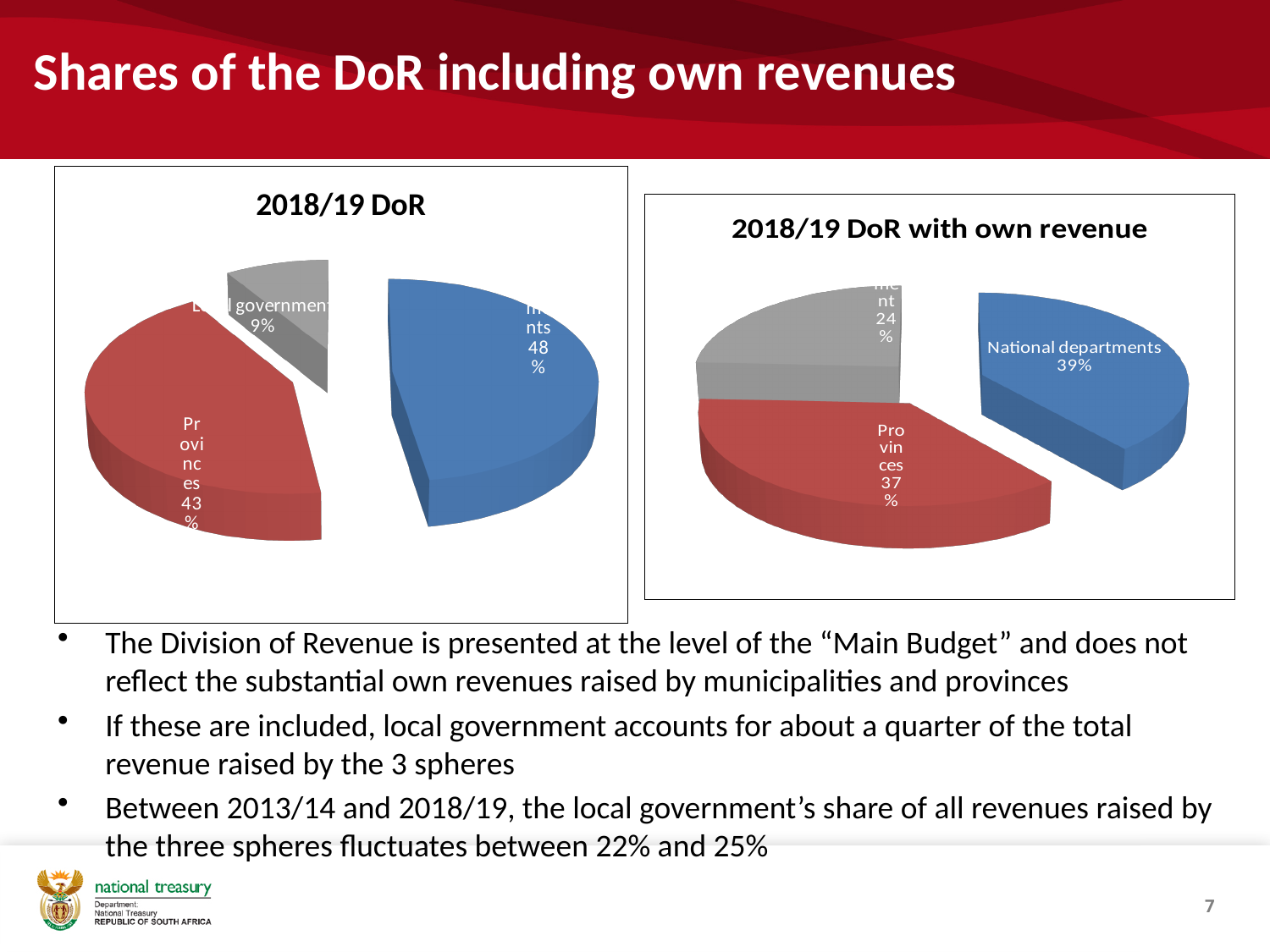
In the 2018/19 DoR with own revenue chart, which category has the largest share? National departments In the 2018/19 DoR with own revenue chart, which is larger, the share for National departments or the share for Provinces? National departments In the 2018/19 DoR with own revenue chart, what share do Provinces have? 37% In the 2018/19 DoR with own revenue chart, what percentage is shown on the grey slice? 24% In the 2018/19 DoR with own revenue chart, what share do National departments have? 39% In the 2018/19 DoR chart, what is the difference between the Provinces share and the Local government share? 34 percentage points In the 2018/19 DoR chart, what share do Provinces have? 43% What colour is the Provinces slice in the 2018/19 DoR chart? Red How many slices does the 2018/19 DoR with own revenue chart have? 3 What type of chart is the 2018/19 DoR chart? Pie chart In the 2018/19 DoR chart, which category has the smallest share? Local government